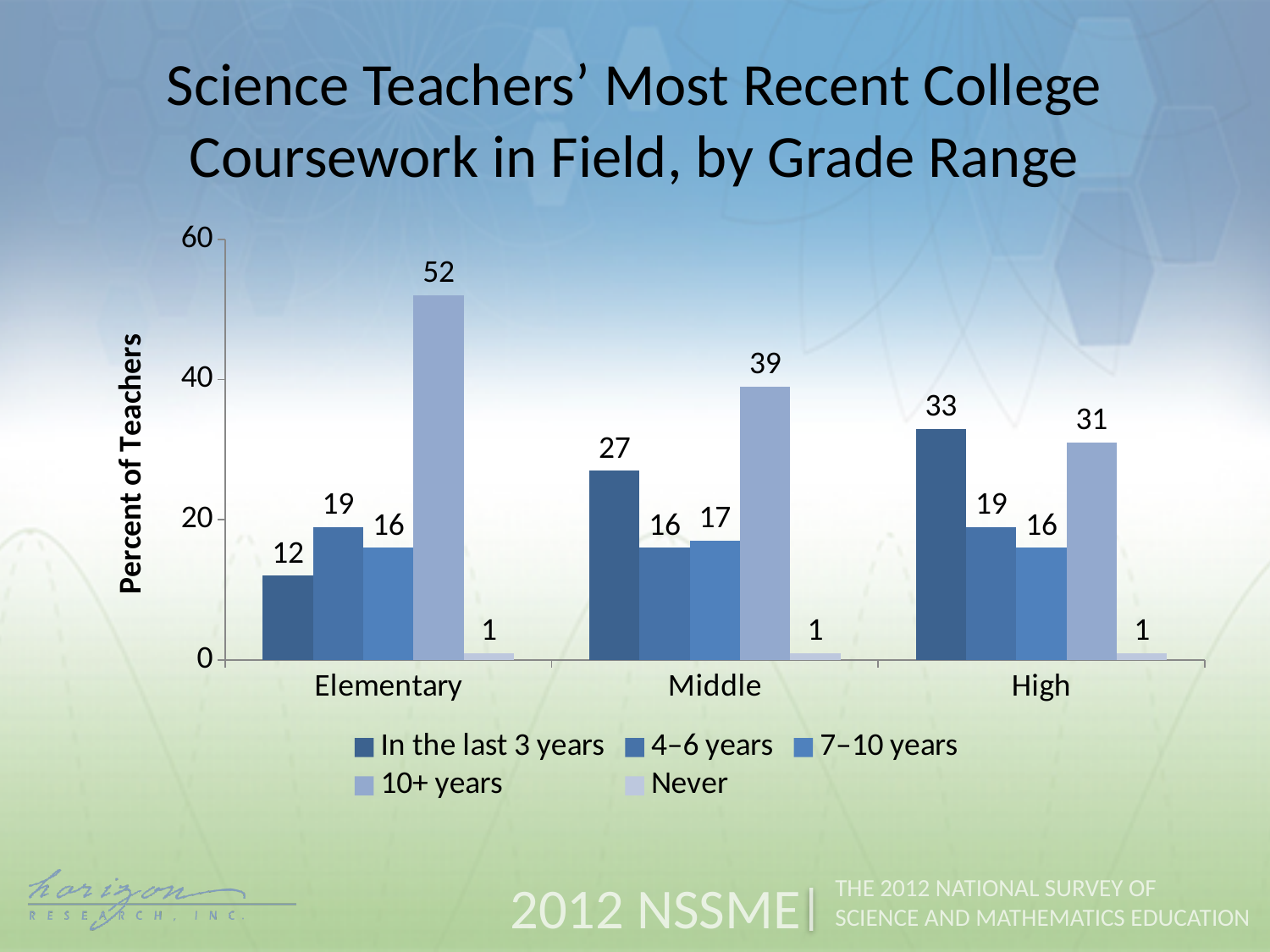
What is the value for 'In the last 3 years' for High school teachers? 33 What is the difference between the '10+ years' values for Elementary and Middle? 13 What is the label of the y axis? Percent of Teachers How many series does the legend list? 5 How many grade ranges are shown on the x axis? 3 Which grade range has the highest value for 'In the last 3 years'? High Which is larger: the 'In the last 3 years' value for Middle or the '4–6 years' value for Middle? In the last 3 years Do the 'In the last 3 years' values rise or fall from Elementary to High? Rise What is the value for '7–10 years' for Middle school teachers? 17 What kind of chart is shown on the slide? Bar chart What percent of elementary science teachers had their most recent college coursework in field 10+ years ago? 52 Which grade range has the lowest value for '10+ years'? High